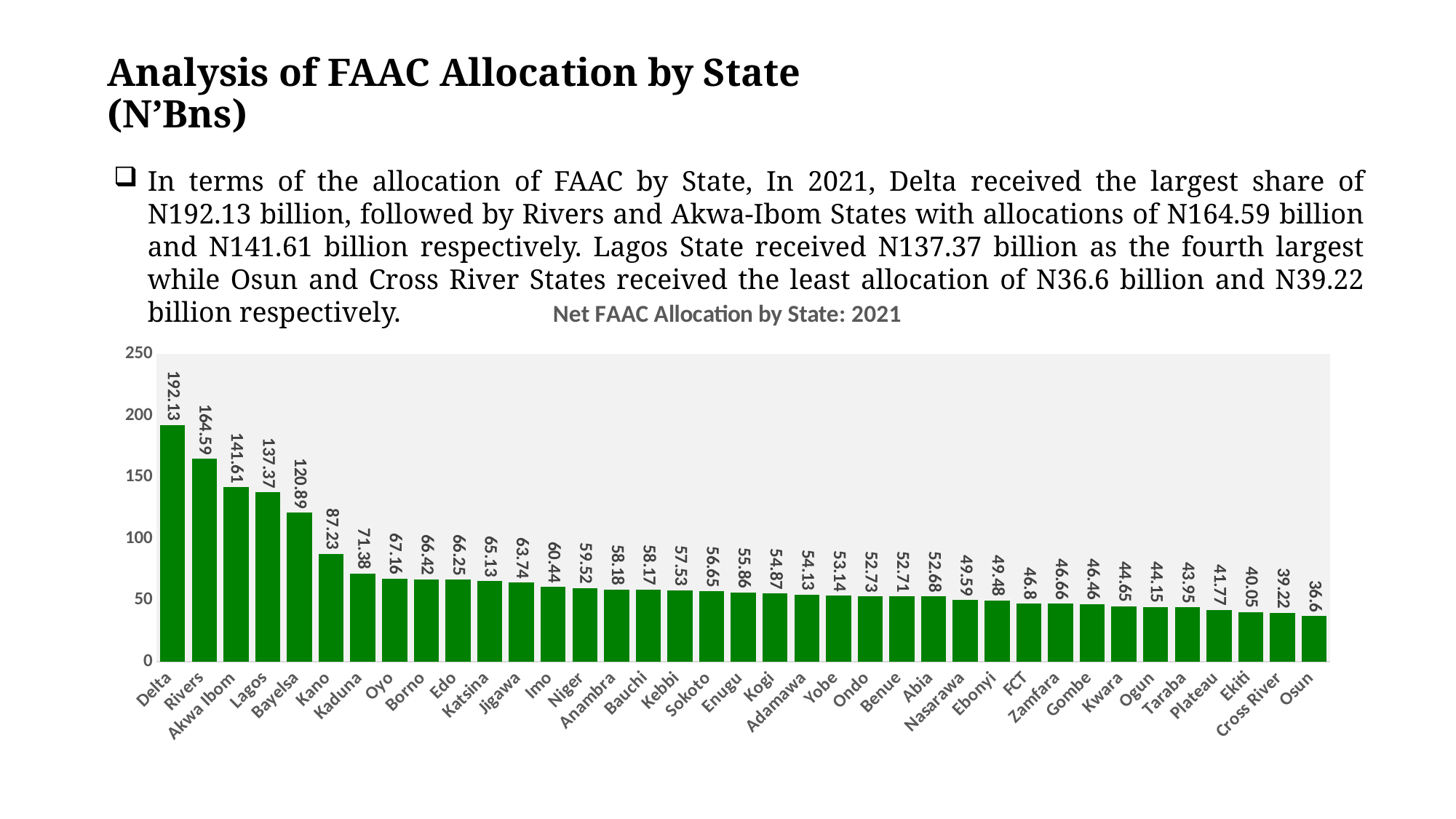
How many states are shown on the chart? 37 What is the value for Cross River? 39.22 What is the value for Kano? 87.23 Which state has the lowest value? Osun Is the value for Bayelsa greater or less than 100? greater What is the title of the chart? Net FAAC Allocation by State: 2021 What kind of chart is this? bar chart What is the value for Delta? 192.13 What is the difference between the values for Delta and Rivers? 27.54 What is the difference between the values for Lagos and Bayelsa? 16.48 Which state has the highest value? Delta Which is larger, the value for Kano or the value for Kaduna? Kano